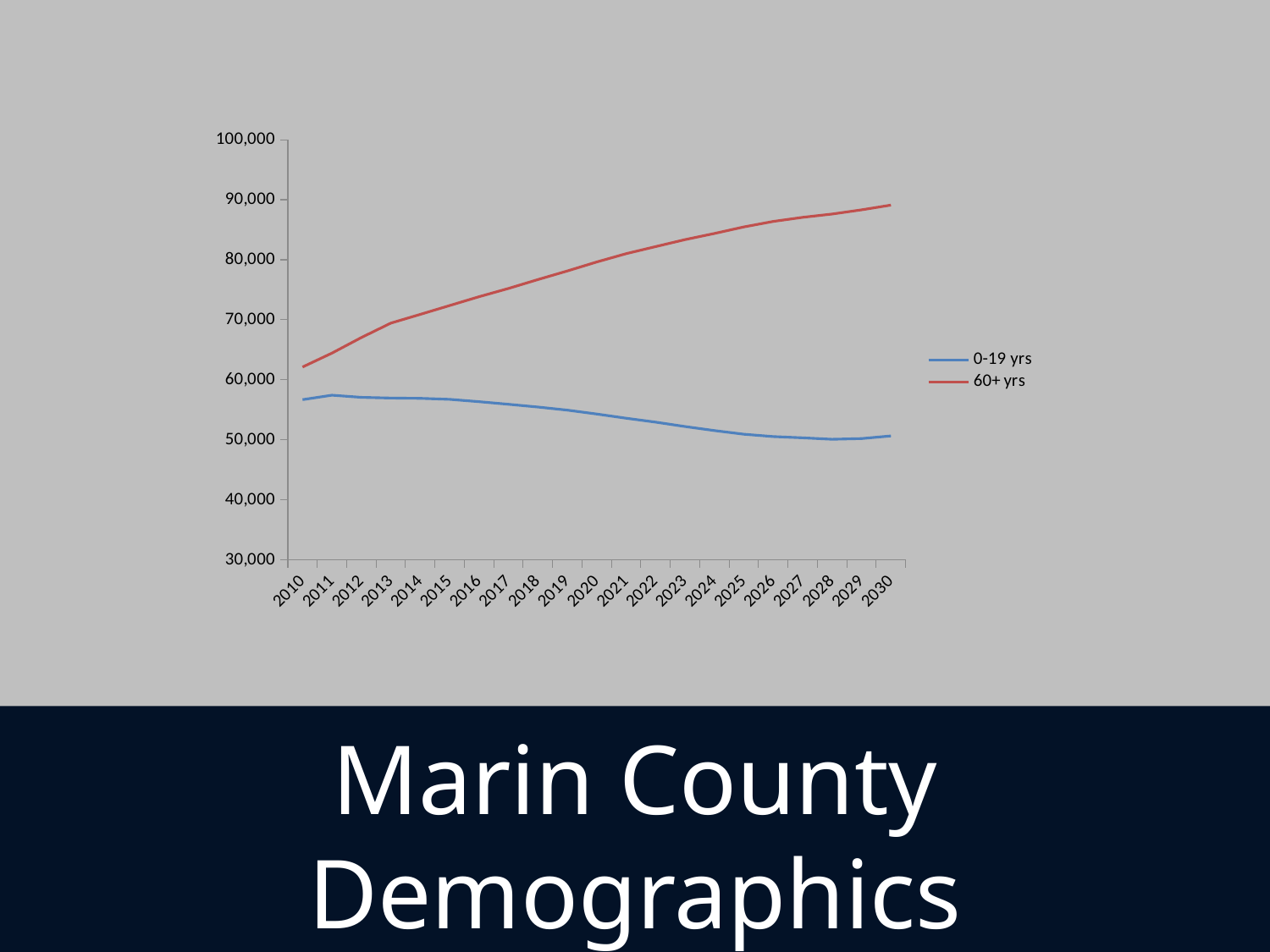
Does the 60+ yrs line rise or fall from 2010 to 2030? rise Is the value for 60+ yrs in 2010 greater or less than 70,000? less Is the value for 0-19 yrs in 2010 greater or less than 50,000? greater Is the value for 0-19 yrs in 2030 greater or less than 60,000? less In 2020, which series has the larger value, 0-19 yrs or 60+ yrs? 60+ yrs What kind of chart is shown on the slide? line chart In which year does the 60+ yrs series reach its highest value? 2030 How many years are shown along the x axis? 21 What are the two series named in the legend? 0-19 yrs and 60+ yrs Does the 0-19 yrs line generally rise or fall from 2011 to 2028? fall How many series does the legend list? 2